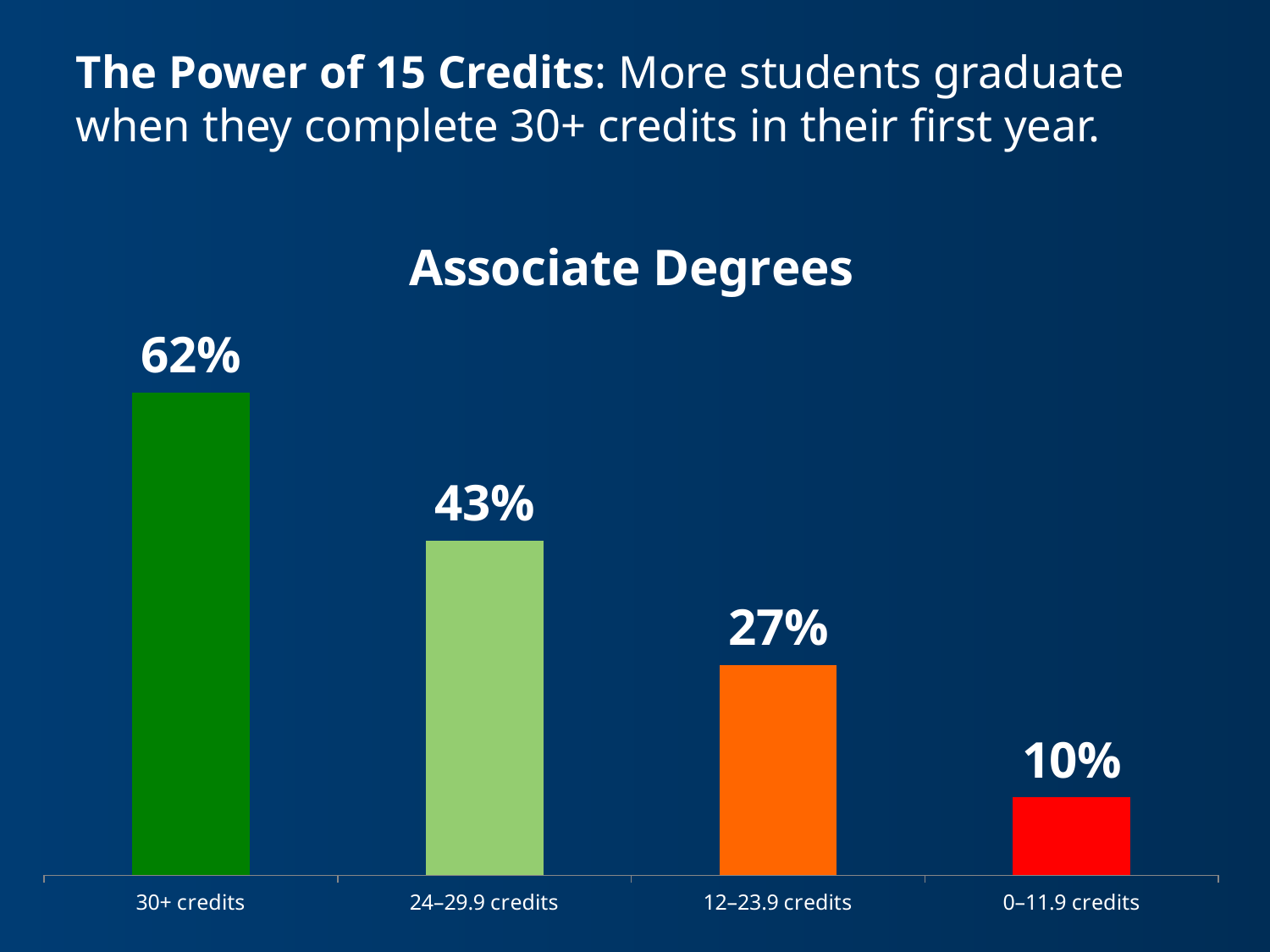
What kind of chart is shown on the slide? Bar chart Which category has the highest value? 30+ credits What is the difference between the values for 30+ credits and 24–29.9 credits? 19% What is the value for 24–29.9 credits? 43% What is the value for 0–11.9 credits? 10% What is the value for 12–23.9 credits? 27% Which is larger, the value for 24–29.9 credits or the value for 12–23.9 credits? 24–29.9 credits What is the difference between the values for 12–23.9 credits and 0–11.9 credits? 17% How many categories are shown in the chart? 4 What is the value for 30+ credits? 62% What is the title of the chart? Associate Degrees Which category has the lowest value? 0–11.9 credits